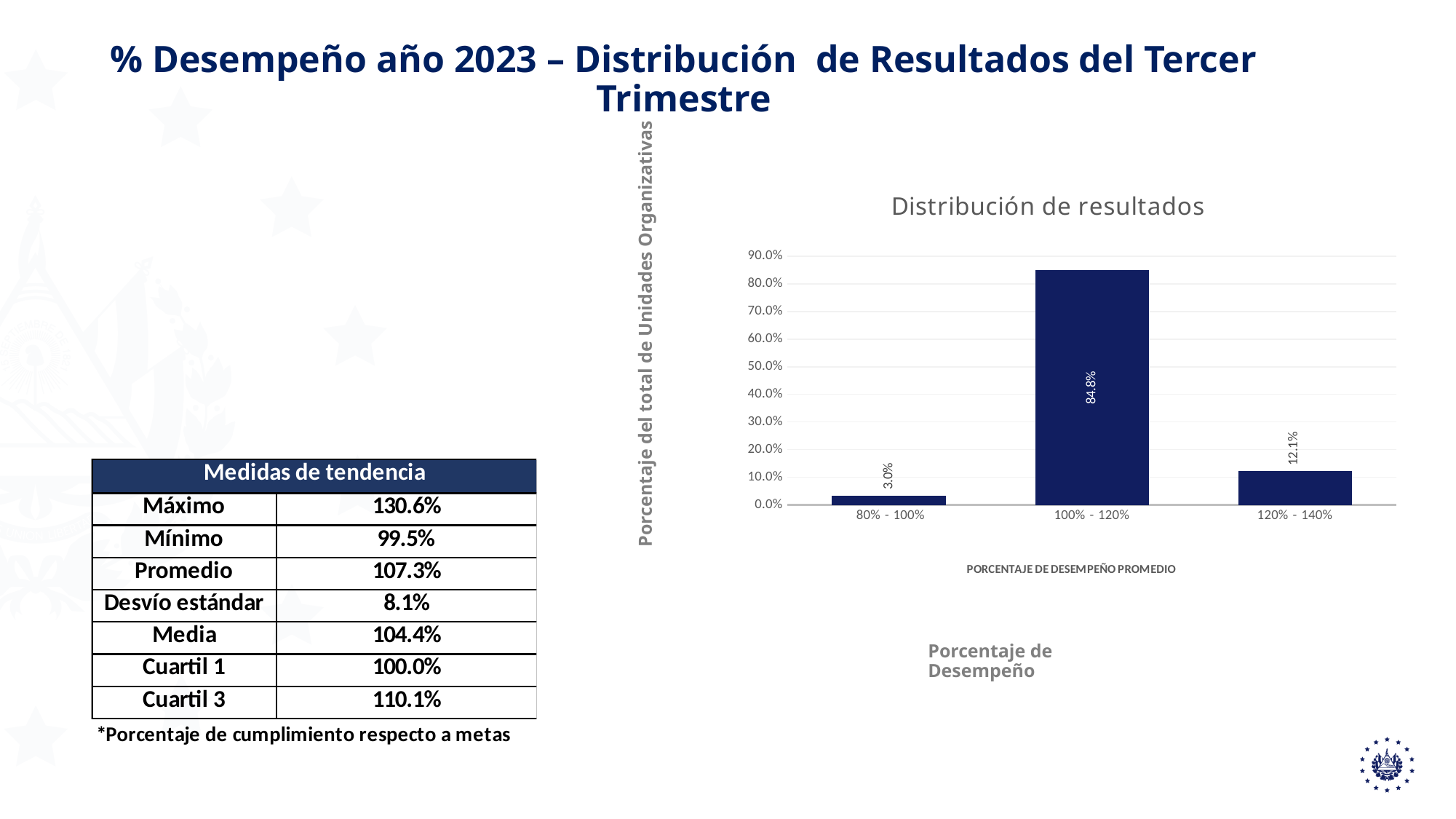
What is the difference between the values for 120% - 140% and 80% - 100%? 9.1% Is the value for 100% - 120% greater or less than 80.0%? greater Which category has the lowest value? 80% - 100% What is the value for the 80% - 100% category? 3.0% What kind of chart is shown? bar chart Which category has the highest value? 100% - 120% What is the value for the 120% - 140% category? 12.1% How many categories are shown on the x axis? 3 What is the difference between the values for 100% - 120% and 120% - 140%? 72.7% What is the value for the 100% - 120% category? 84.8% Which is larger, the value for 120% - 140% or the value for 80% - 100%? 120% - 140% What is the title of the chart? Distribución de resultados